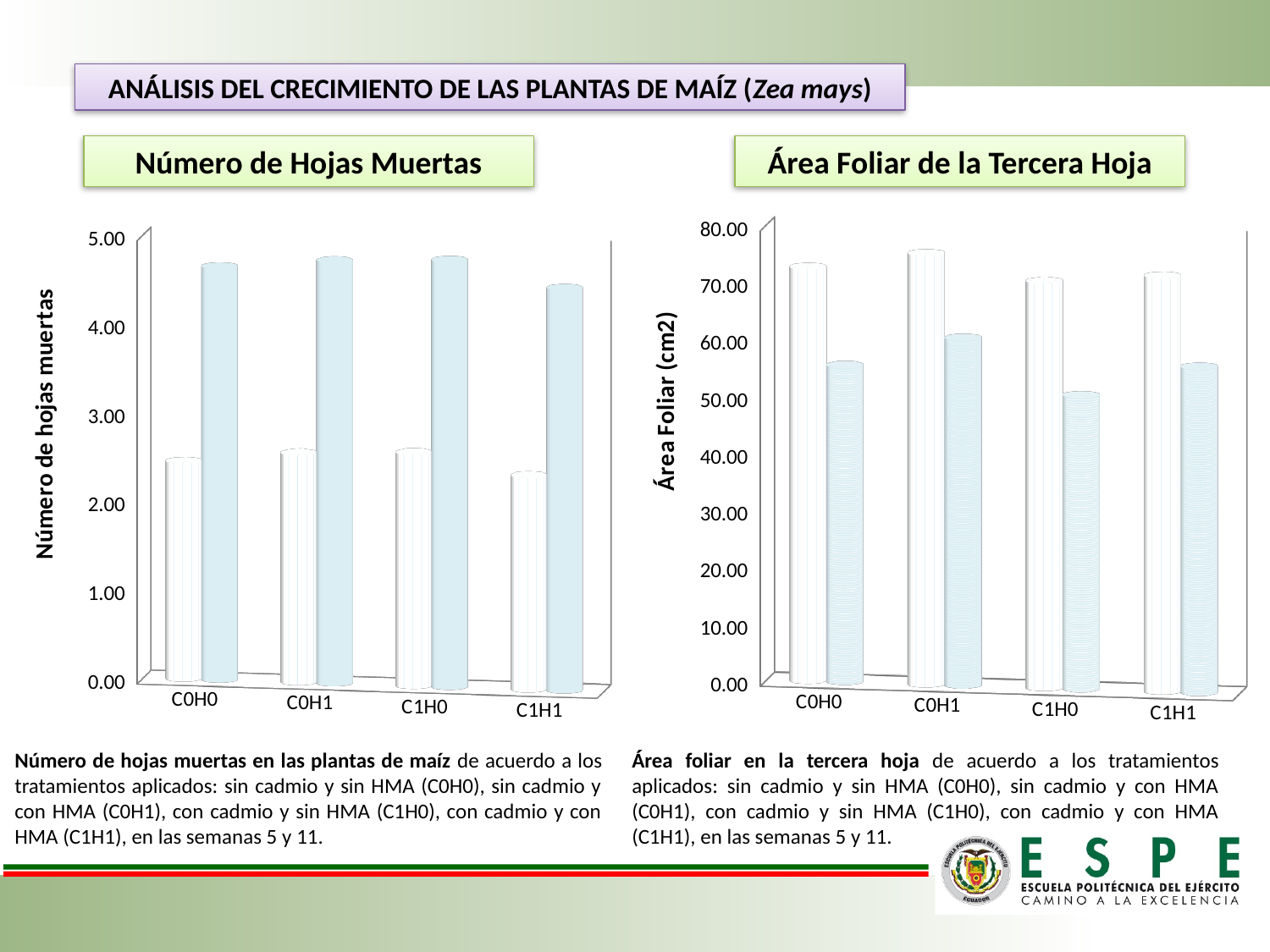
In the 'Área Foliar de la Tercera Hoja' chart, which category has the lowest light blue (second) bar? C1H0 What is the y-axis title of the 'Área Foliar de la Tercera Hoja' chart? Área Foliar (cm2) In the 'Área Foliar de la Tercera Hoja' chart, which category has the tallest white (first) bar? C0H1 In the 'Área Foliar de la Tercera Hoja' chart, is the value of the light blue (second) bar for C1H0 greater or less than 60.00? less In the 'Área Foliar de la Tercera Hoja' chart, is the light blue (second) bar larger for C0H1 or for C1H0? C0H1 In the 'Número de Hojas Muertas' chart, which category has the lowest light blue (second) bar? C1H1 In the 'Número de Hojas Muertas' chart, is the value of the white (first) bar for C0H0 greater or less than 3.00? less In the 'Número de Hojas Muertas' chart, is the value of the light blue (second) bar for C0H0 greater or less than 4.00? greater What kind of chart is the 'Número de Hojas Muertas' chart? bar chart How many treatment categories are shown on the x axis of the 'Área Foliar de la Tercera Hoja' chart? 4 In the 'Número de Hojas Muertas' chart, which category has the lowest white (first) bar? C1H1